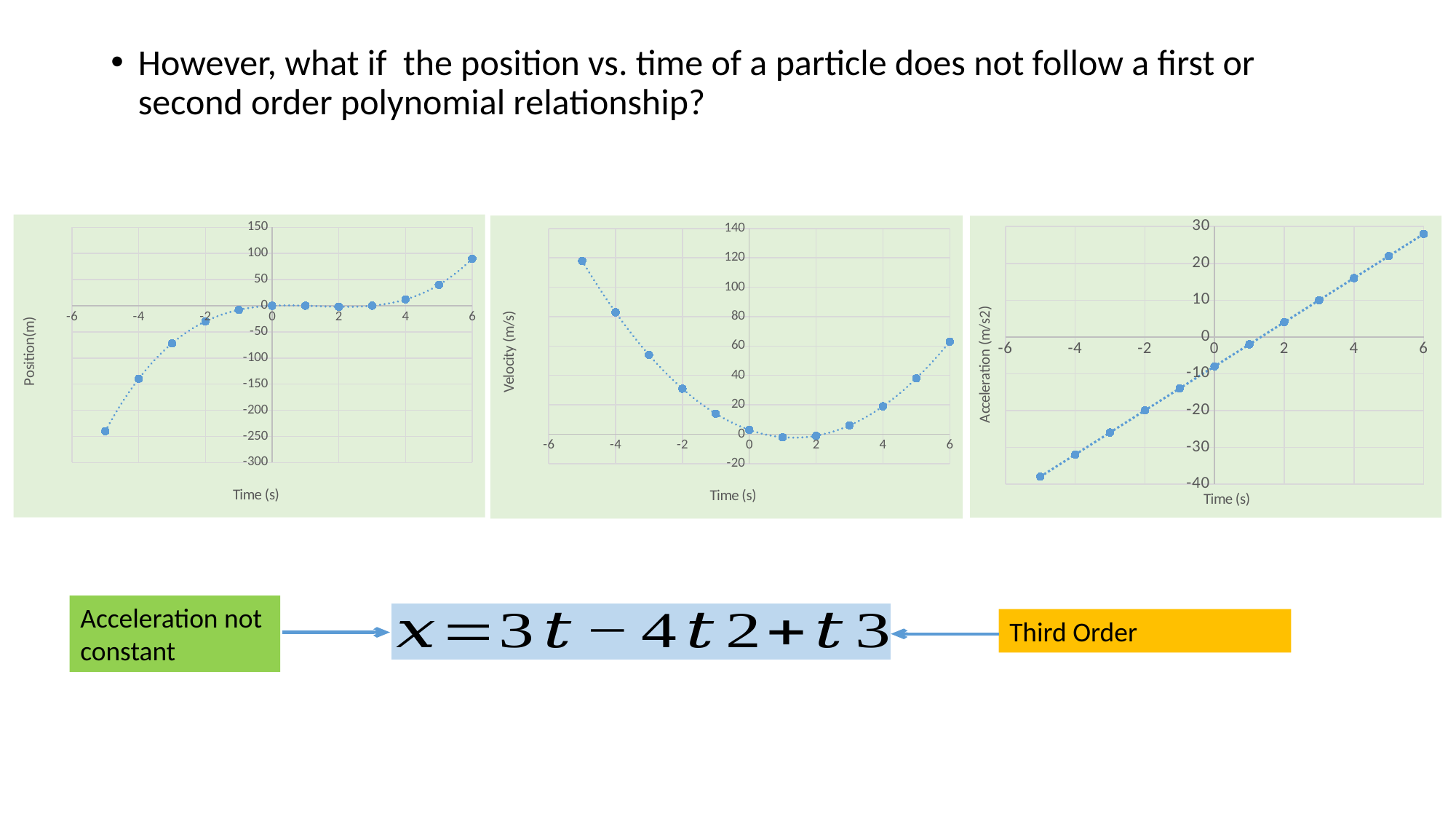
In the left chart (Position vs Time), is the position at time -5 greater or less than -200? less In the left chart (Position vs Time), at which time is the position lowest? -5 What is the y-axis title of the right chart? Acceleration (m/s2) In the right chart (Acceleration vs Time), do the values rise or fall as time increases? rise How many data points are plotted in the right chart (Acceleration vs Time)? 12 In the middle chart (Velocity vs Time), is the velocity at time 6 greater or less than 40? greater In the middle chart (Velocity vs Time), is the velocity at time -5 greater or less than 100? greater In the left chart (Position vs Time), at which time is the position highest? 6 In the middle chart (Velocity vs Time), at which time is the velocity highest? -5